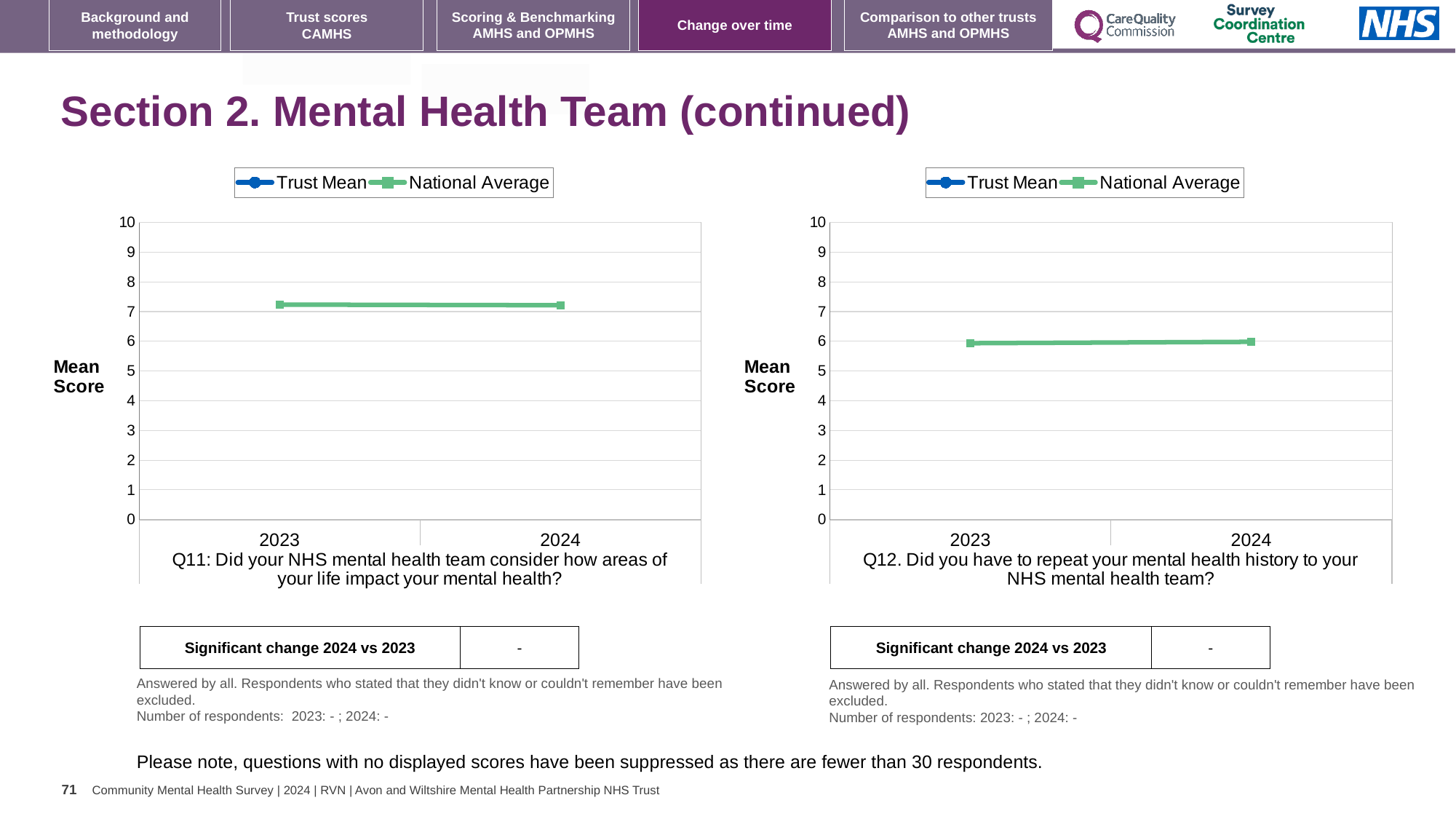
What are the two series named in the legend of the right chart (Q12)? Trust Mean and National Average What kind of chart is the left chart (Q11)? line chart In the right chart (Q12), is the National Average value for 2024 greater or less than 7? less In the right chart (Q12), is the National Average value for 2023 greater or less than 5? greater How many years are shown on the x axis of the left chart (Q11)? 2 In the left chart (Q11), is the National Average value for 2024 greater or less than 8? less What kind of chart is the right chart (Q12)? line chart What is the label on the y axis of the left chart (Q11)? Mean Score How many series does the legend of the left chart (Q11) list? 2 How many series does the legend of the right chart (Q12) list? 2 How many years are shown on the x axis of the right chart (Q12)? 2